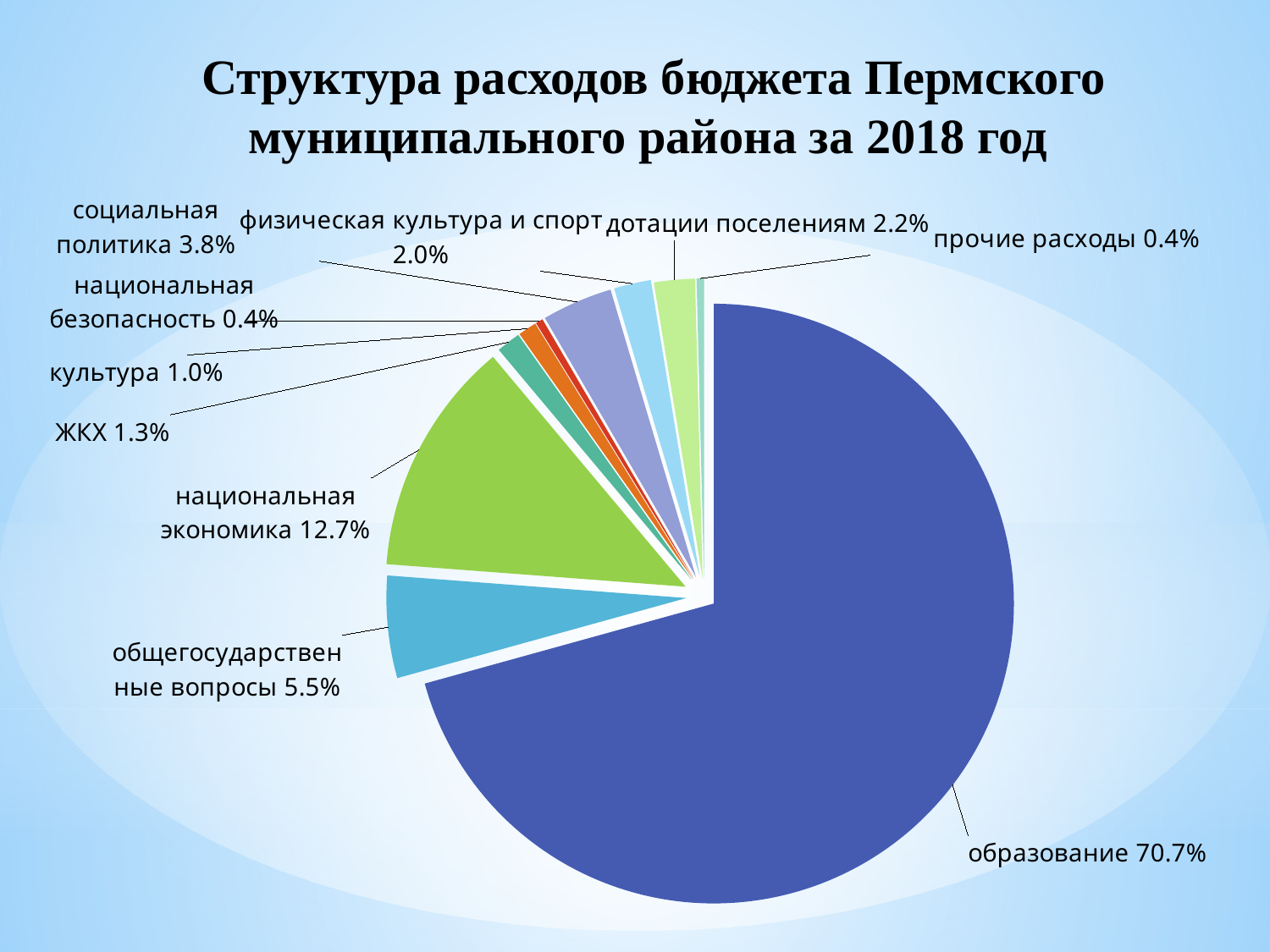
Which category has the largest share of the pie? образование What is the value for национальная экономика? 12.7% What kind of chart is shown on the slide? pie chart What is the title of the chart on the slide? Структура расходов бюджета Пермского муниципального района за 2018 год What is the difference between the shares of образование and национальная экономика? 58.0% What is the value for социальная политика? 3.8% Which is larger: физическая культура и спорт or культура? физическая культура и спорт What share of the budget expenditure goes to образование? 70.7% What is the value for ЖКХ? 1.3% How many categories are shown in the pie chart? 10 What is the value for дотации поселениям? 2.2% What is the value for общегосударственные вопросы? 5.5%